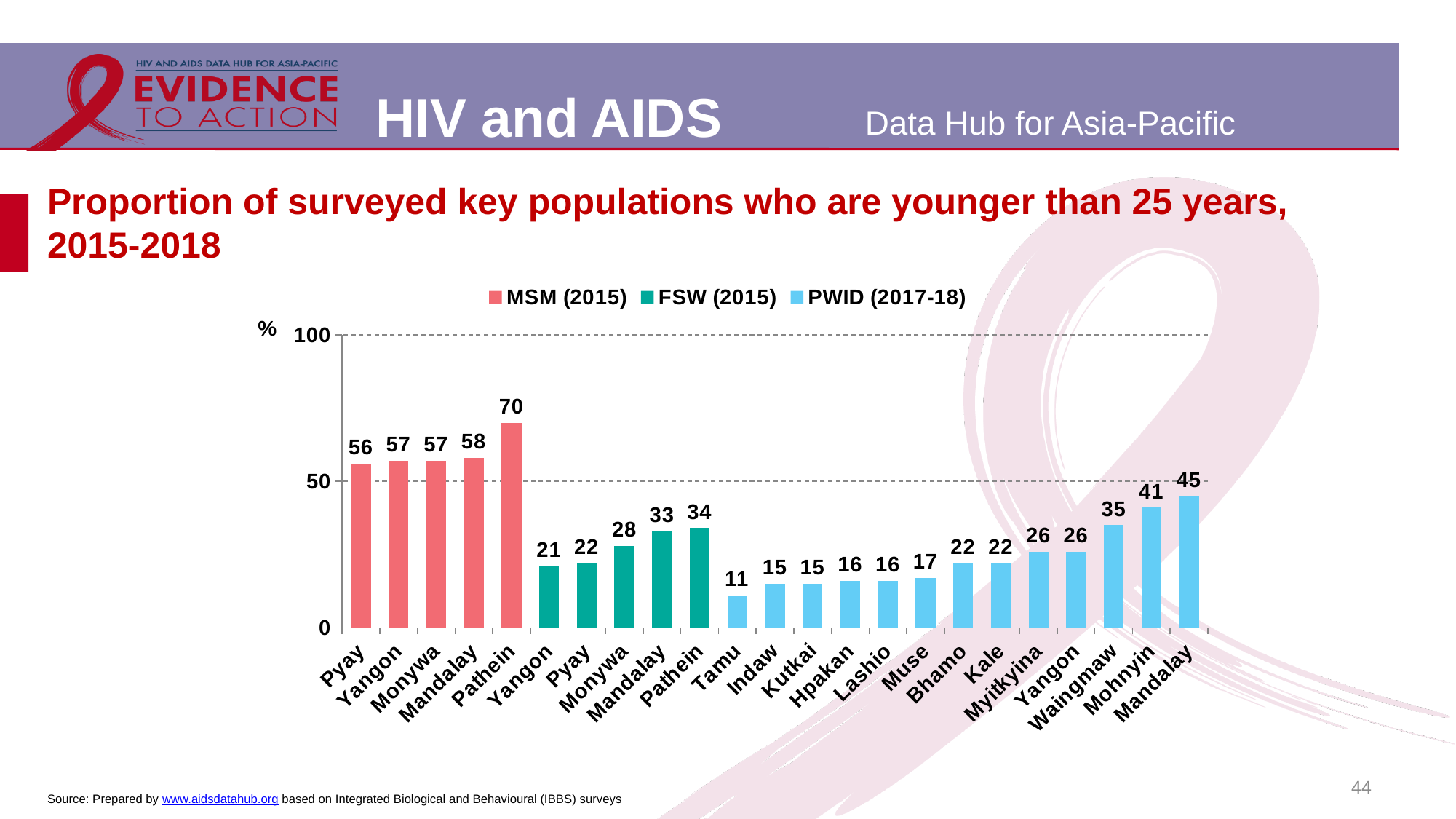
Which location has the highest value in the MSM (2015) series? Pathein What is the value for Pathein in the MSM (2015) series? 70 Which location has the lowest value in the PWID (2017-18) series? Tamu How many series does the legend list? 3 Which is larger: the FSW (2015) value for Mandalay or the PWID (2017-18) value for Mandalay? PWID (2017-18) value for Mandalay Is the PWID (2017-18) value for Mohnyin greater or less than 50? less How many bars are plotted in the PWID (2017-18) series? 13 What is the difference between the MSM (2015) value for Pathein and the MSM (2015) value for Pyay? 14 What is the value for Mandalay in the PWID (2017-18) series? 45 What colour are the bars for the FSW (2015) series? green What is the value for Monywa in the FSW (2015) series? 28 What kind of chart is shown on the slide? bar chart